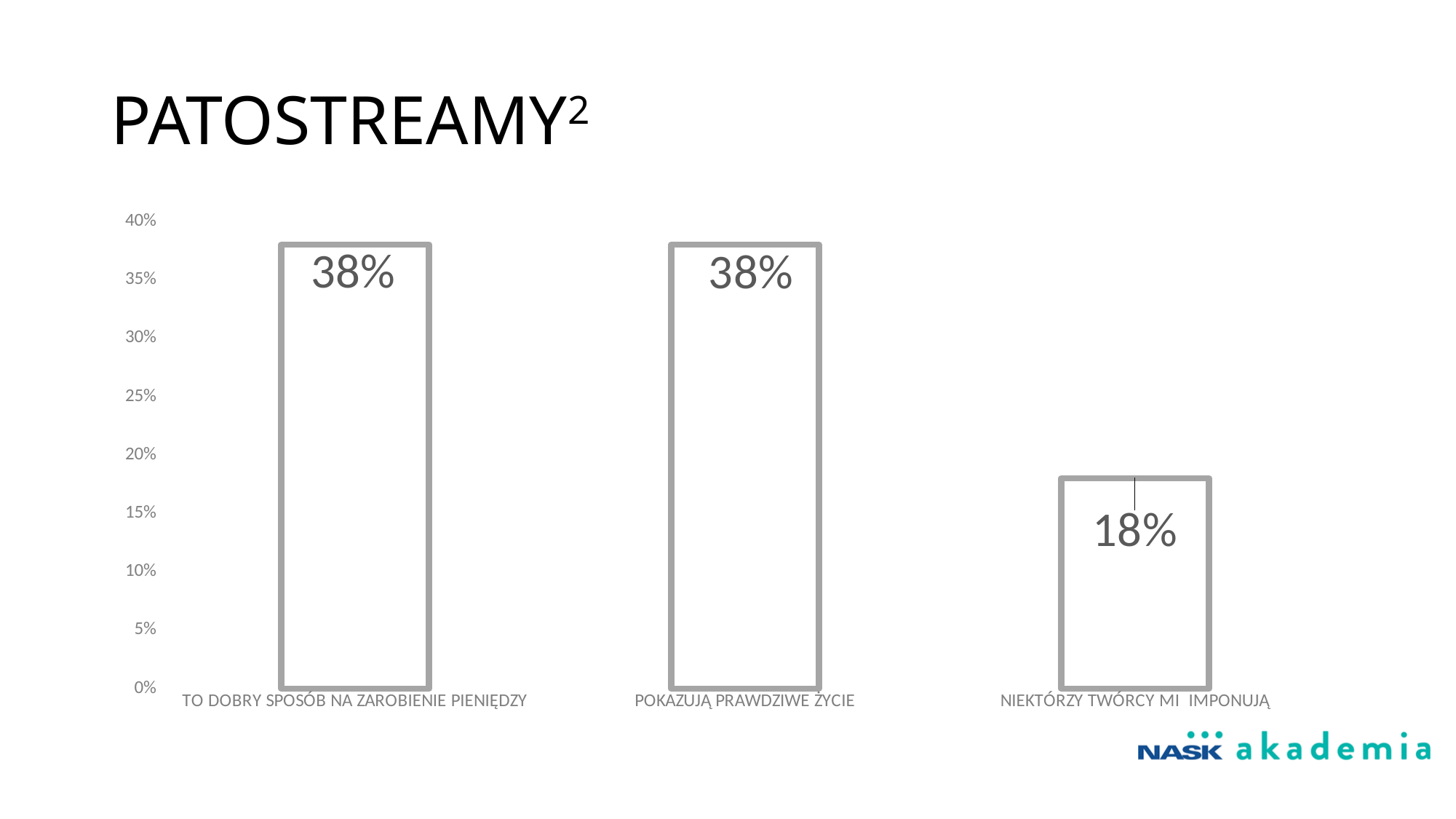
What is the value for "POKAZUJĄ PRAWDZIWE ŻYCIE"? 38% What is the highest value shown on the vertical axis? 40% What kind of chart is shown on the slide? bar chart Which category has the lowest value? NIEKTÓRZY TWÓRCY MI IMPONUJĄ What is the value for "NIEKTÓRZY TWÓRCY MI IMPONUJĄ"? 18% Is the value for "NIEKTÓRZY TWÓRCY MI IMPONUJĄ" greater or less than 20%? less Which is larger: the value for "TO DOBRY SPOSÓB NA ZAROBIENIE PIENIĘDZY" or the value for "NIEKTÓRZY TWÓRCY MI IMPONUJĄ"? TO DOBRY SPOSÓB NA ZAROBIENIE PIENIĘDZY Is the value for "POKAZUJĄ PRAWDZIWE ŻYCIE" greater or less than 35%? greater How many categories are shown in the chart? 3 What is the difference between the values for "POKAZUJĄ PRAWDZIWE ŻYCIE" and "NIEKTÓRZY TWÓRCY MI IMPONUJĄ"? 20% What is the title of the slide? PATOSTREAMY What is the value for "TO DOBRY SPOSÓB NA ZAROBIENIE PIENIĘDZY"? 38%